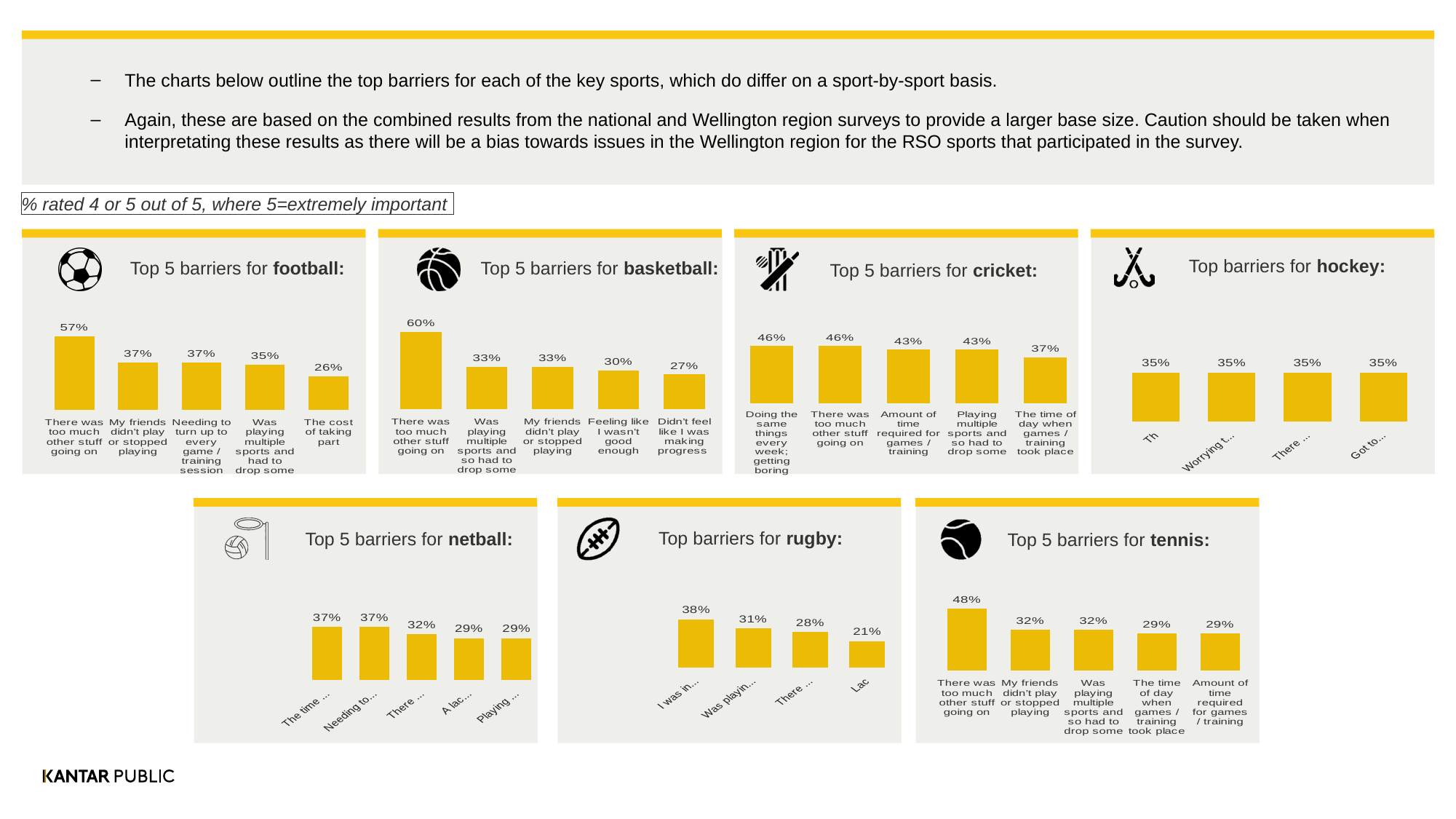
What type of chart is used in the 'Top 5 barriers for netball' panel? Bar chart In the 'Top barriers for hockey' chart, how many bars are plotted? 4 In the 'Top 5 barriers for football' chart, what percentage is shown for 'The cost of taking part'? 26% In the 'Top 5 barriers for basketball' chart, which barrier has the highest percentage? There was too much other stuff going on In the 'Top 5 barriers for basketball' chart, which barrier has the lowest percentage? Didn't feel like I was making progress In the 'Top 5 barriers for netball' chart, what is the highest percentage shown? 37% In the 'Top barriers for rugby' chart, what is the lowest percentage shown? 21% In the 'Top 5 barriers for cricket' chart, what percentage is shown for 'The time of day when games / training took place'? 37% In the 'Top 5 barriers for tennis' chart, what is the difference in percentage points between 'There was too much other stuff going on' and 'My friends didn't play or stopped playing'? 16 percentage points In the 'Top 5 barriers for cricket' chart, which is larger: 'Amount of time required for games / training' or 'The time of day when games / training took place'? Amount of time required for games / training In the 'Top 5 barriers for football' chart, what is the difference in percentage points between the highest and lowest bars? 31 percentage points In the 'Top barriers for rugby' chart, how many bars are plotted? 4